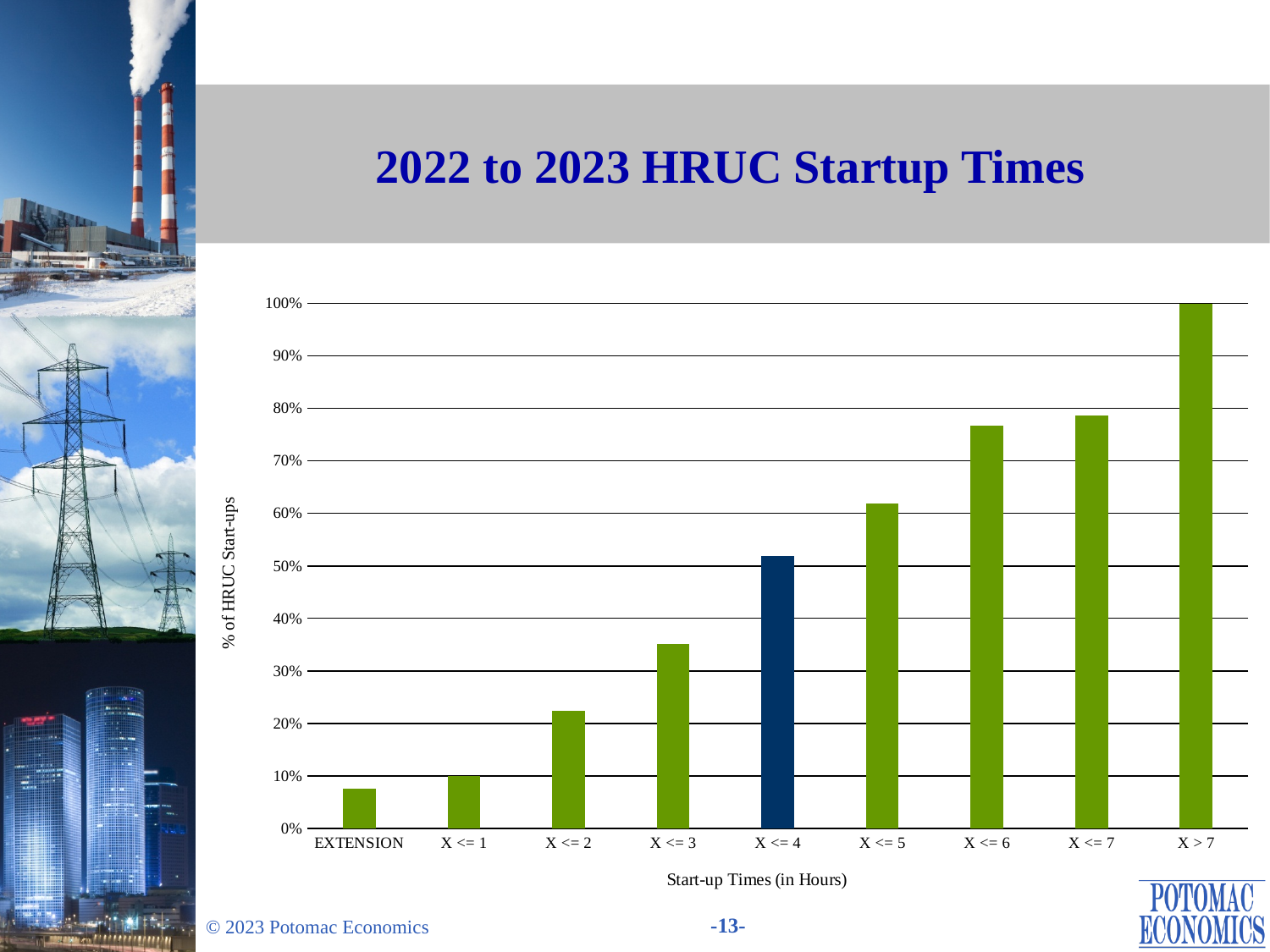
What kind of chart is shown on the slide? bar chart What is the title of the x axis of the chart? Start-up Times (in Hours) How many categories are shown on the x axis of the chart? 9 Is the value for X <= 3 greater or less than 30%? greater Which category has the highest % of HRUC Start-ups? X > 7 Is the value for X <= 4 greater or less than 50%? greater Is the value for X <= 6 greater or less than 80%? less Do the values rise or fall moving from EXTENSION to X > 7 along the x axis? rise What is the % of HRUC Start-ups for X > 7? 100% Which category has the lowest % of HRUC Start-ups? EXTENSION Which is larger, the value for X <= 3 or the value for X <= 5? X <= 5